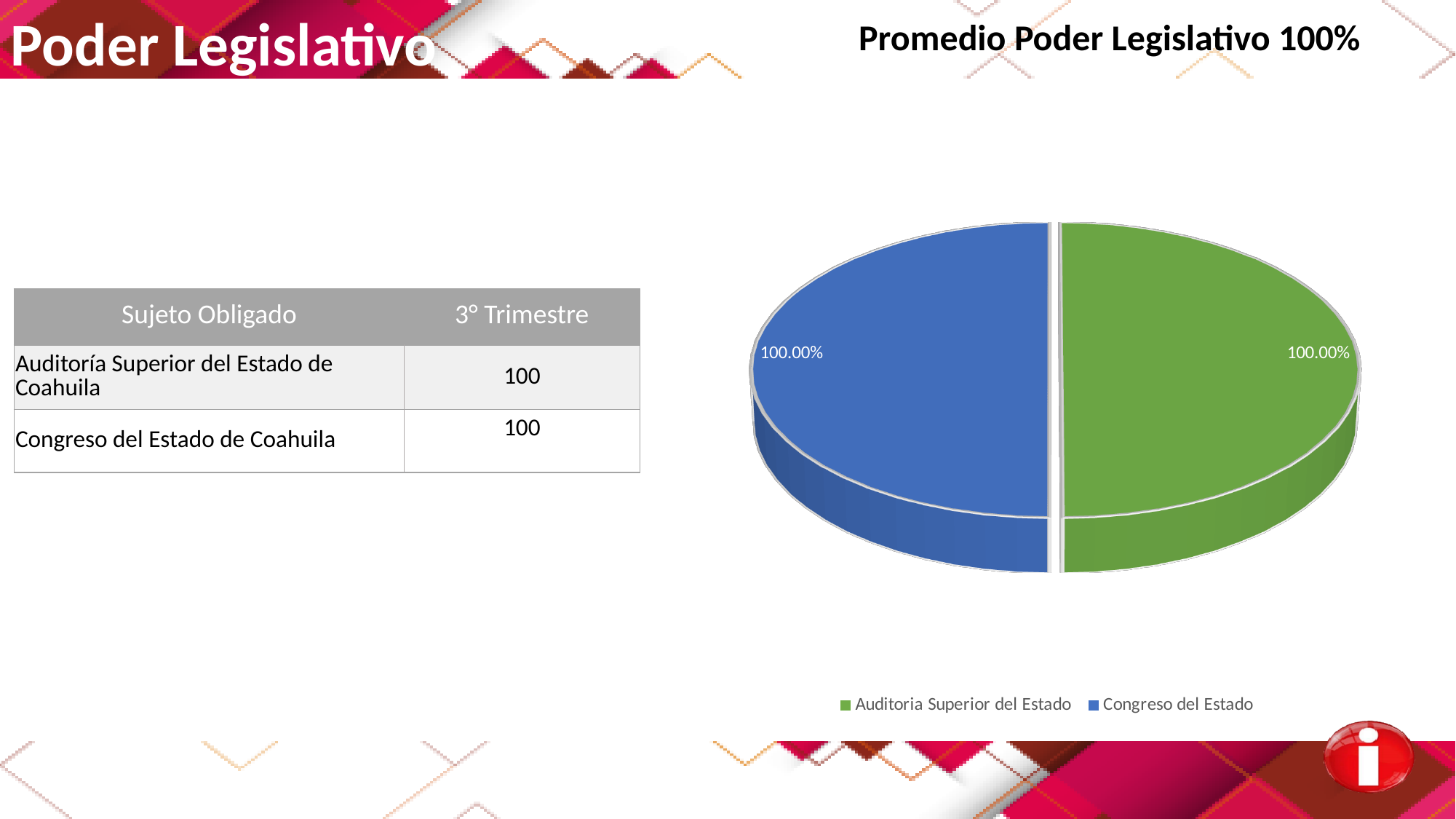
What is the title shown above the pie chart? Promedio Poder Legislativo 100% What data label is shown on the Congreso del Estado slice of the pie chart? 100.00% How many entries does the legend of the pie chart list? 2 Which colour represents Congreso del Estado in the pie chart? blue What data label is shown on the Auditoria Superior del Estado slice of the pie chart? 100.00% Is the data label for the Congreso del Estado slice greater or less than 50%? greater How many slices does the pie chart have? 2 What kind of chart is shown on the slide? pie chart